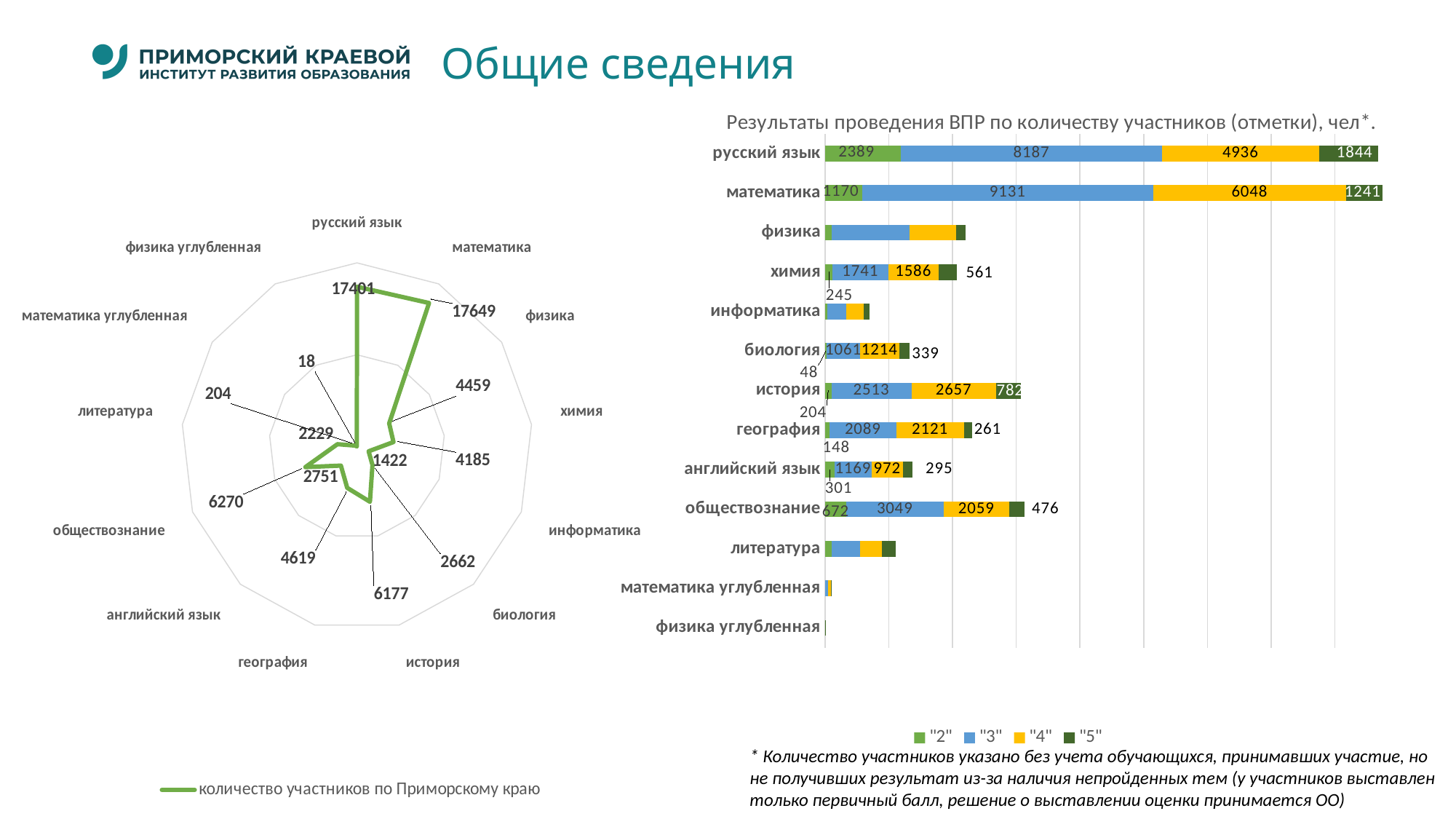
In the stacked bar chart on the right, what is the total number of participants for история? 6156 In the radar chart on the left, which subject has the lowest number of participants? физика углубленная In the stacked bar chart on the right, how many series does the legend list? 4 In the stacked bar chart on the right, how many participants received a "3" in русский язык? 8187 In the stacked bar chart on the right, how many participants received a "4" in математика? 6048 In the stacked bar chart on the right, what is the difference between the "3" and "4" marks for обществознание? 990 In the radar chart on the left, how many subjects are plotted? 13 In the radar chart on the left, what is the number of participants for математика? 17649 In the radar chart on the left, what is the difference between the participants for обществознание and история? 93 In the radar chart on the left, which subject has the highest number of participants? математика In the stacked bar chart on the right, which is larger: the number of "5" marks in русский язык or in математика? русский язык What type of chart is the chart on the right? stacked bar chart